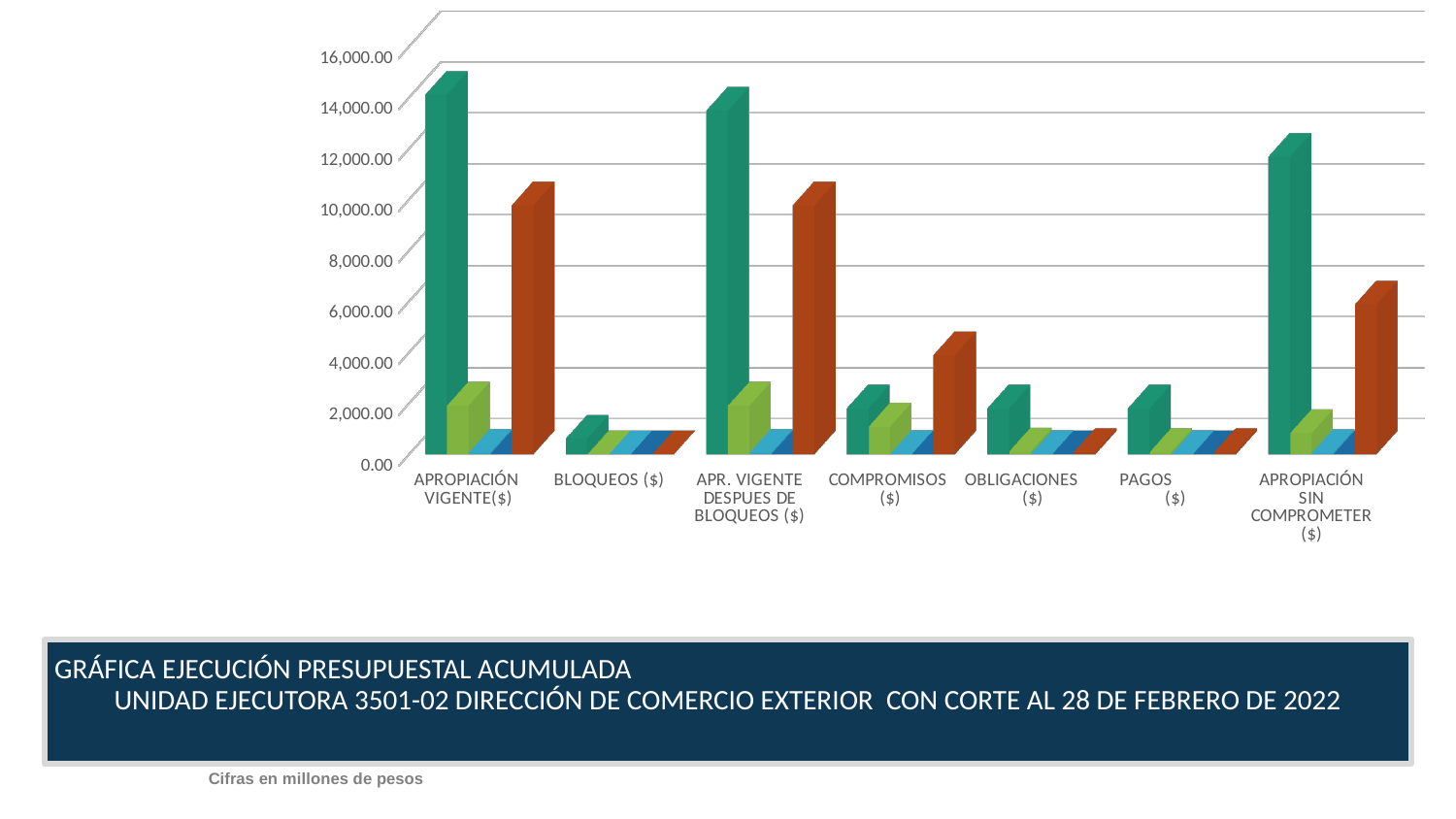
Which is larger: the teal bar for APROPIACIÓN SIN COMPROMETER ($) or the teal bar for COMPROMISOS ($)? APROPIACIÓN SIN COMPROMETER ($) How many categories are shown along the x axis of the chart? 7 Which category has the lowest teal bar? BLOQUEOS ($) Is the value of the teal bar for APROPIACIÓN SIN COMPROMETER ($) greater or less than 10,000.00? greater What is the cut-off date stated in the chart title? 28 de febrero de 2022 According to the note below the chart, in what units are the figures expressed? Millones de pesos Is the value of the orange bar for APROPIACIÓN SIN COMPROMETER ($) greater or less than 4,000.00? greater Which is larger: the orange bar for COMPROMISOS ($) or the orange bar for APROPIACIÓN SIN COMPROMETER ($)? APROPIACIÓN SIN COMPROMETER ($) What kind of chart is shown on the slide? Bar chart Is the value of the orange bar for COMPROMISOS ($) greater or less than 6,000.00? less